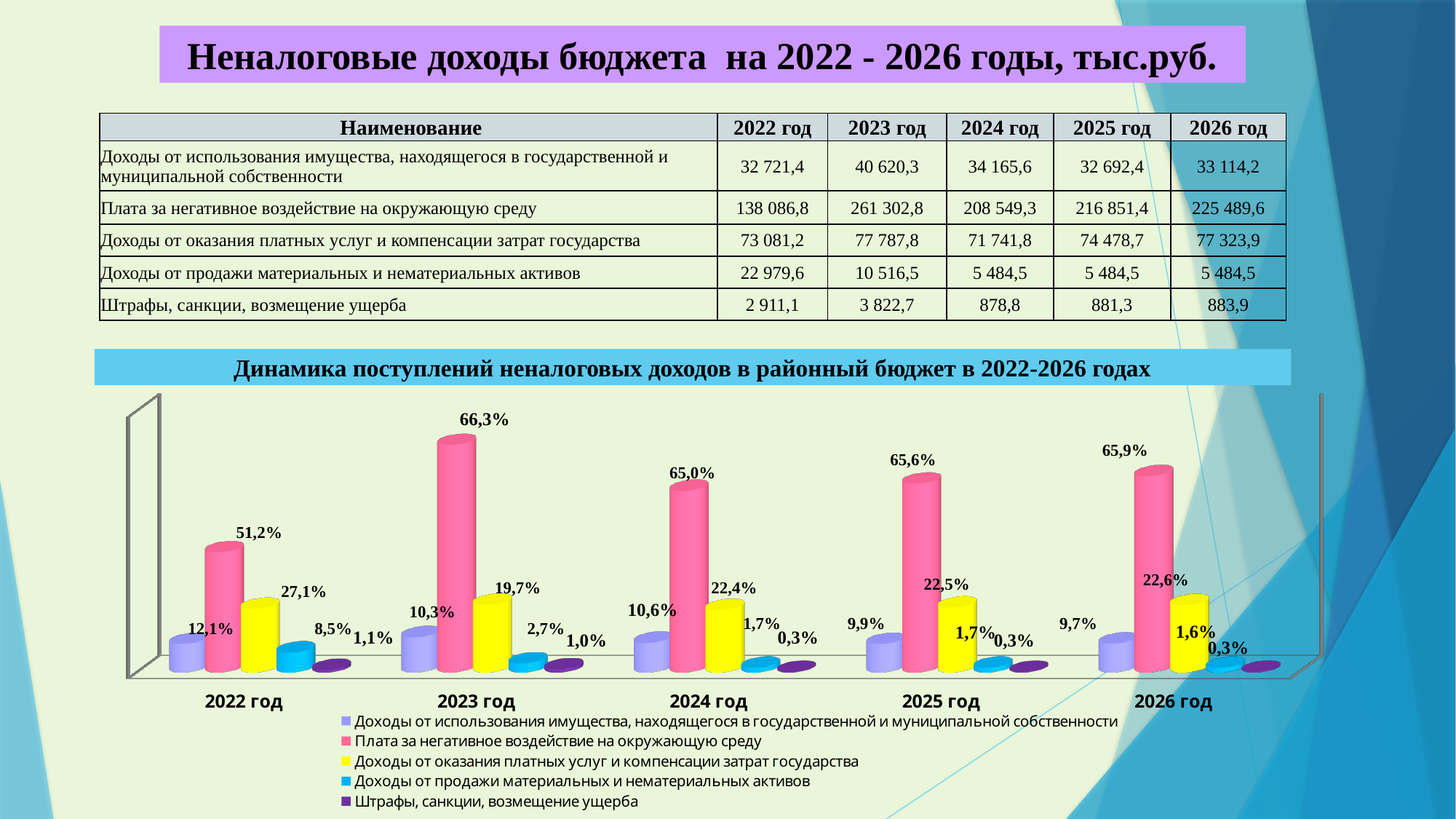
In the chart, does the value for "Доходы от продажи материальных и нематериальных активов" rise or fall from 2022 год to 2026 год? fall In the chart, which year has the highest value for "Плата за негативное воздействие на окружающую среду"? 2023 год In the chart, which is larger in 2022 год: "Доходы от использования имущества, находящегося в государственной и муниципальной собственности" or "Доходы от продажи материальных и нематериальных активов"? Доходы от использования имущества, находящегося в государственной и муниципальной собственности What type of chart is shown under the title "Динамика поступлений неналоговых доходов в районный бюджет в 2022-2026 годах"? bar chart How many year categories are shown on the x axis of the chart? 5 In the chart, what is the value for "Доходы от оказания платных услуг и компенсации затрат государства" in 2022 год? 27,1% How many series does the chart legend list? 5 In the chart, which year has the lowest value for "Доходы от использования имущества, находящегося в государственной и муниципальной собственности"? 2026 год In the chart, what is the value for "Плата за негативное воздействие на окружающую среду" in 2023 год? 66,3% In the chart, what is the value for "Доходы от продажи материальных и нематериальных активов" in 2024 год? 1,7% In the chart, what is the difference between the 2023 and 2022 values for "Плата за негативное воздействие на окружающую среду"? 15,1% In the chart, what is the value for "Штрафы, санкции, возмещение ущерба" in 2026 год? 0,3%